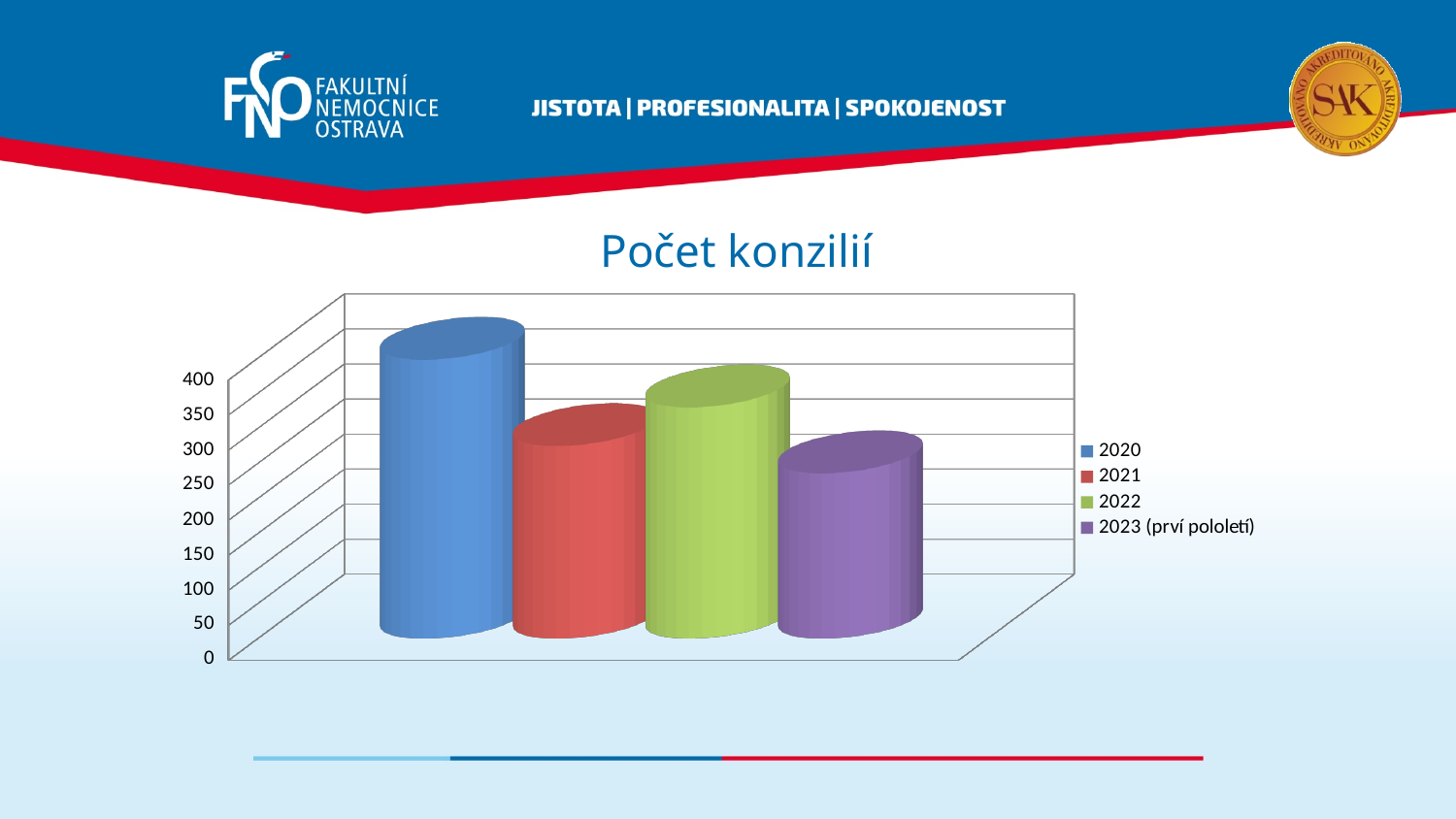
What is the title of the chart? Počet konzilií Is the value for 2020 greater or less than 300? greater Which series has the highest value? 2020 What type of chart is shown on the slide? bar chart Which is larger, the value for 2020 or the value for 2021? 2020 Which series has the lowest value? 2023 (prví pololetí) Is the value for 2023 (prví pololetí) greater or less than 400? less How many series does the legend list? 4 How many bars are plotted in the chart? 4 What colour is the bar for 2022? green Is the value for 2021 greater or less than 200? greater Which is larger, the value for 2021 or the value for 2022? 2022